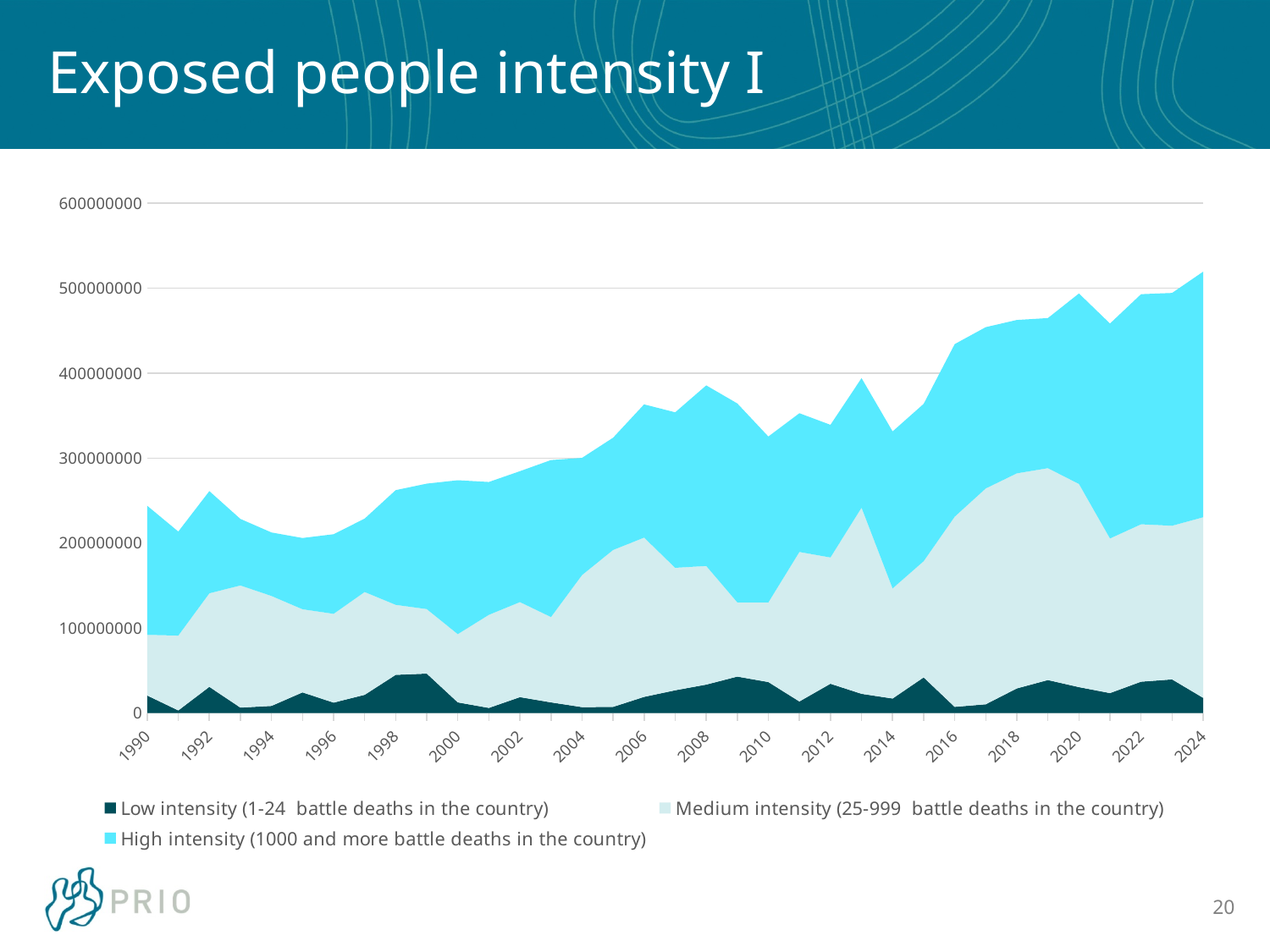
What is the title of the chart on the slide? Exposed people intensity I What kind of chart is shown on the slide? Stacked area chart How many series does the legend list? 3 Is the total stacked value larger in 2024 or in 1990? 2024 Is the total stacked value for 2000 greater or less than 300000000? less Is the total stacked value for 2024 greater or less than 500000000? greater Which series does the legend describe as '1000 and more battle deaths in the country'? High intensity Is the total stacked value for 2016 greater or less than 400000000? greater Does the total number of exposed people generally rise or fall from 1990 to 2024? rise In 2024, which series contributes more: High intensity or Low intensity? High intensity Which year has the highest total stacked value? 2024